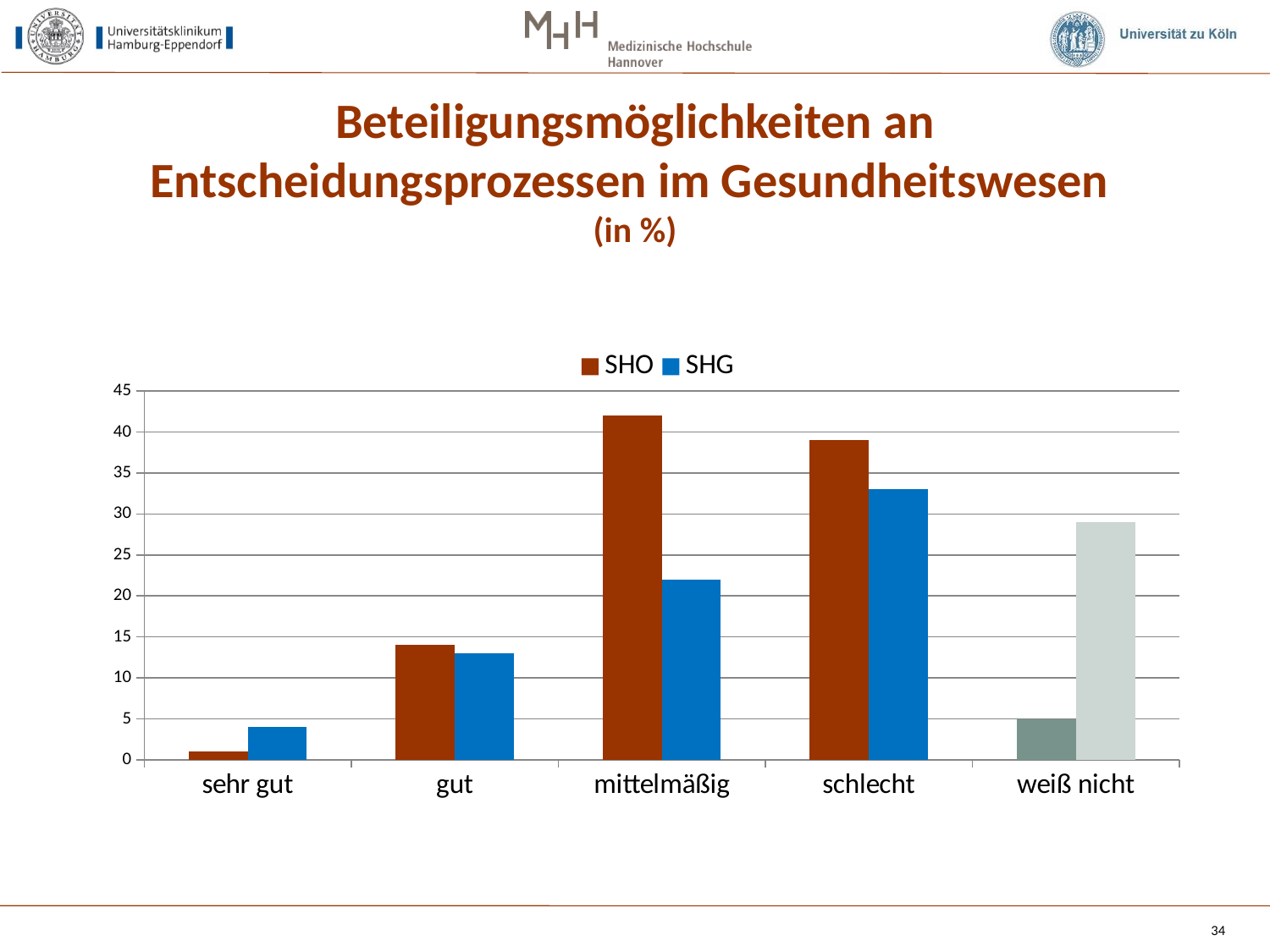
Is the SHG value for weiß nicht greater or less than 30? less How many series does the legend list? 2 Which category has the lowest value for SHO? sehr gut Is the SHG value for mittelmäßig greater or less than 20? greater Which category has the highest value for SHG? schlecht Which category has the highest value for SHO? mittelmäßig What are the two series named in the legend? SHO and SHG How many categories are shown on the x axis? 5 What kind of chart is shown on the slide? bar chart For weiß nicht, which series has the larger value, SHO or SHG? SHG Is the SHO value for mittelmäßig greater or less than 40? greater For mittelmäßig, which series has the larger value, SHO or SHG? SHO